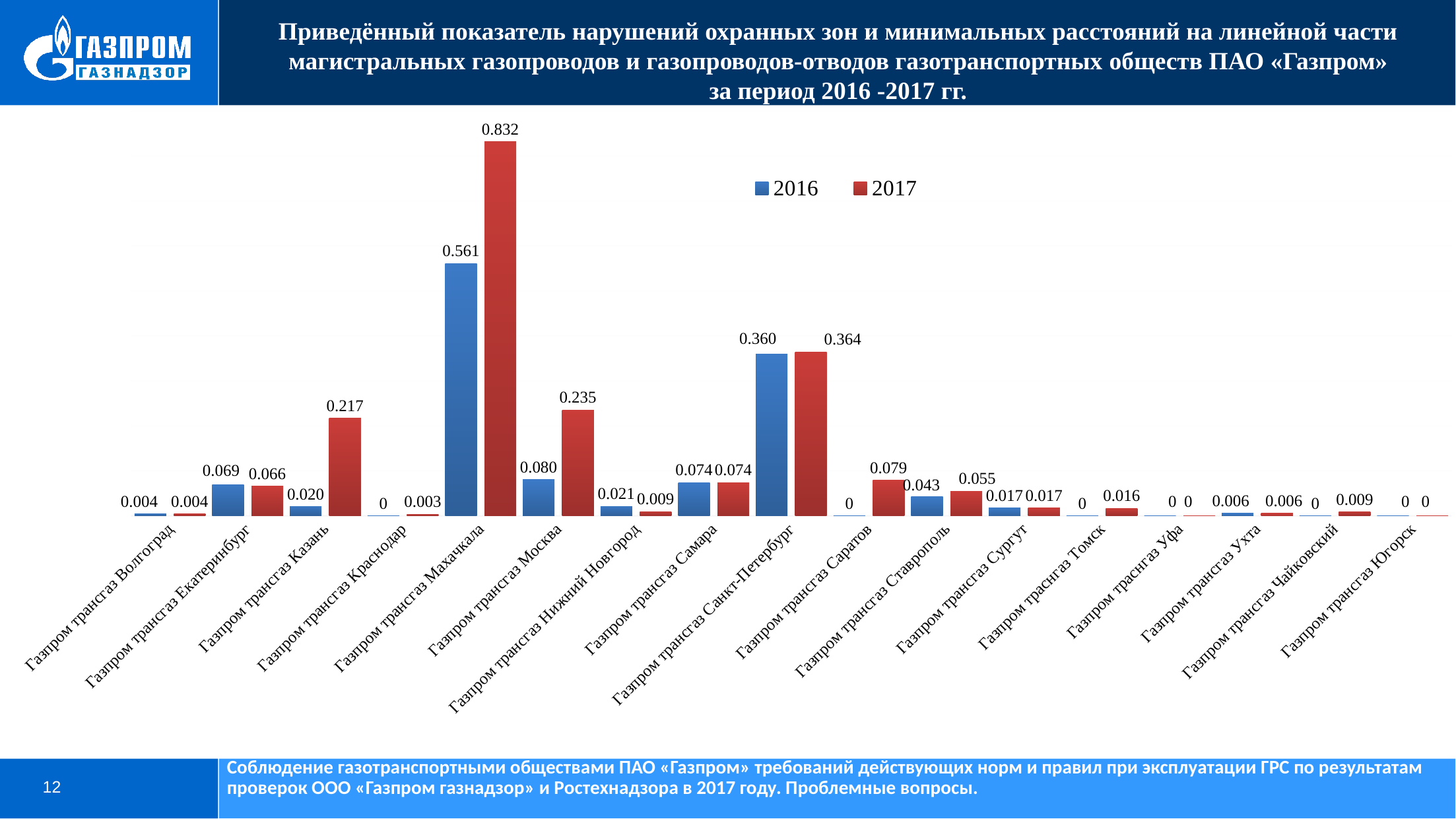
What is the difference between the 2017 and 2016 values for Газпром трансгаз Москва? 0.155 What is the 2017 value for Газпром трансгаз Махачкала? 0.832 How many series does the legend list? 2 What is the 2017 value for Газпром трансгаз Казань? 0.217 What is the 2016 value for Газпром трансгаз Санкт-Петербург? 0.360 Which company has the highest 2016 value? Газпром трансгаз Махачкала What is the difference between the 2017 and 2016 values for Газпром трансгаз Махачкала? 0.271 Which is larger for Газпром трансгаз Нижний Новгород: the 2016 value or the 2017 value? 2016 What type of chart is shown on the slide? Bar chart Which company has the highest 2017 value? Газпром трансгаз Махачкала How many companies (categories) are shown on the x axis? 17 What is the 2016 value for Газпром трансгаз Москва? 0.080